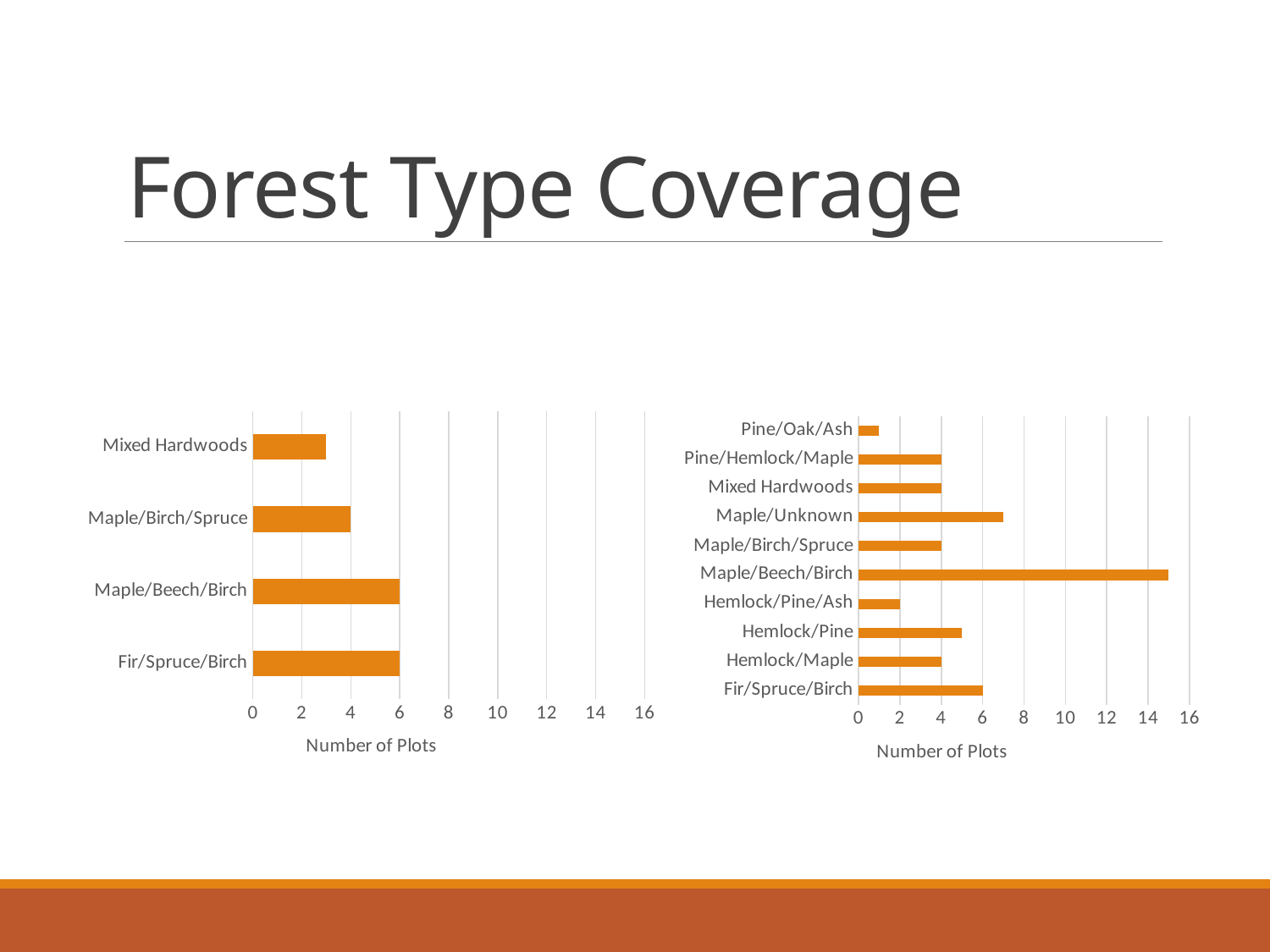
In the right chart, how many plots does Hemlock/Pine/Ash have? 2 In the right chart, which forest type has the most plots? Maple/Beech/Birch In the right chart, which has more plots, Hemlock/Pine or Hemlock/Pine/Ash? Hemlock/Pine In the left chart, which forest type has the fewest plots? Mixed Hardwoods How many forest types are shown in the left chart? 4 In the left chart, how many plots does Maple/Birch/Spruce have? 4 In the left chart, is the value for Mixed Hardwoods greater or less than 4? less In the right chart, is the value for Maple/Beech/Birch greater or less than 14? greater How many forest types are shown in the right chart? 10 In the left chart, what is the difference in number of plots between Maple/Beech/Birch and Maple/Birch/Spruce? 2 In the right chart, which forest type has the fewest plots? Pine/Oak/Ash What kind of chart is the left chart on the slide? bar chart